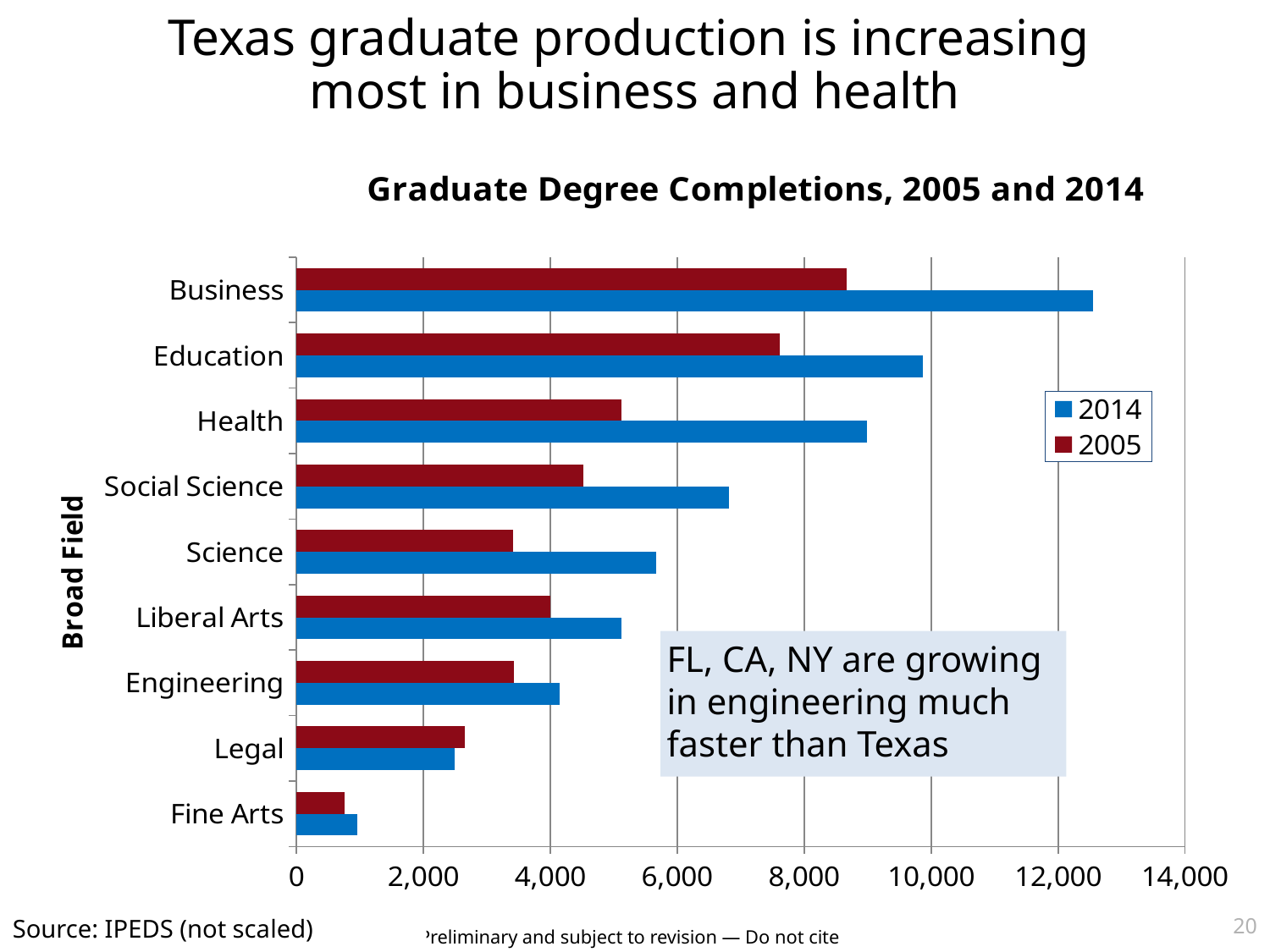
Is the 2005 value for Health greater or less than 6,000? less What is the label on the vertical axis of the chart? Broad Field Which is larger in 2014: Liberal Arts or Engineering? Liberal Arts Which is larger in 2014: Education or Health? Education Is the 2014 value for Social Science greater or less than 6,000? greater What is the title of the chart? Graduate Degree Completions, 2005 and 2014 Is the 2014 value for Business greater or less than 12,000? greater How many series does the legend list? 2 Which broad field has the lowest number of graduate degree completions in 2014? Fine Arts What kind of chart is shown on the slide? bar chart How many broad fields are listed on the chart? 9 Which broad field has the highest number of graduate degree completions in 2014? Business